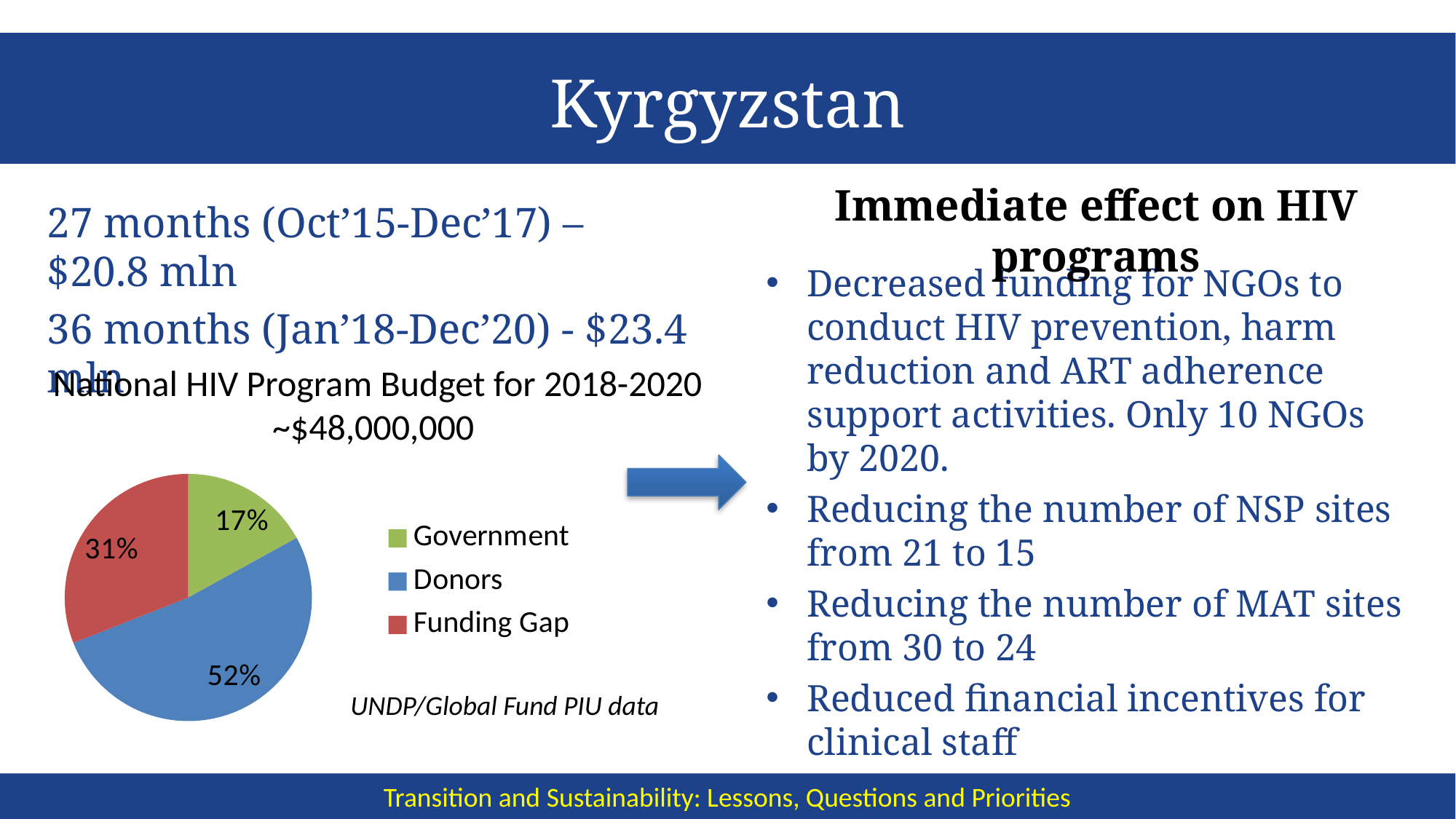
Which is larger in the pie chart, Government or Funding Gap? Funding Gap What colour is the Donors slice in the pie chart? Blue What is the title of the pie chart? National HIV Program Budget for 2018-2020 ~$48,000,000 What share of the National HIV Program Budget for 2018-2020 pie chart is Government? 17% What is the difference in percentage points between the Funding Gap slice and the Government slice? 14 What type of chart is shown on the slide? Pie chart What share of the National HIV Program Budget for 2018-2020 pie chart is Donors? 52% What share of the National HIV Program Budget for 2018-2020 pie chart is the Funding Gap? 31% What is the difference in percentage points between the Donors slice and the Funding Gap slice? 21 Which slice of the pie chart is the largest? Donors How many slices does the pie chart have? 3 Which slice of the pie chart is the smallest? Government